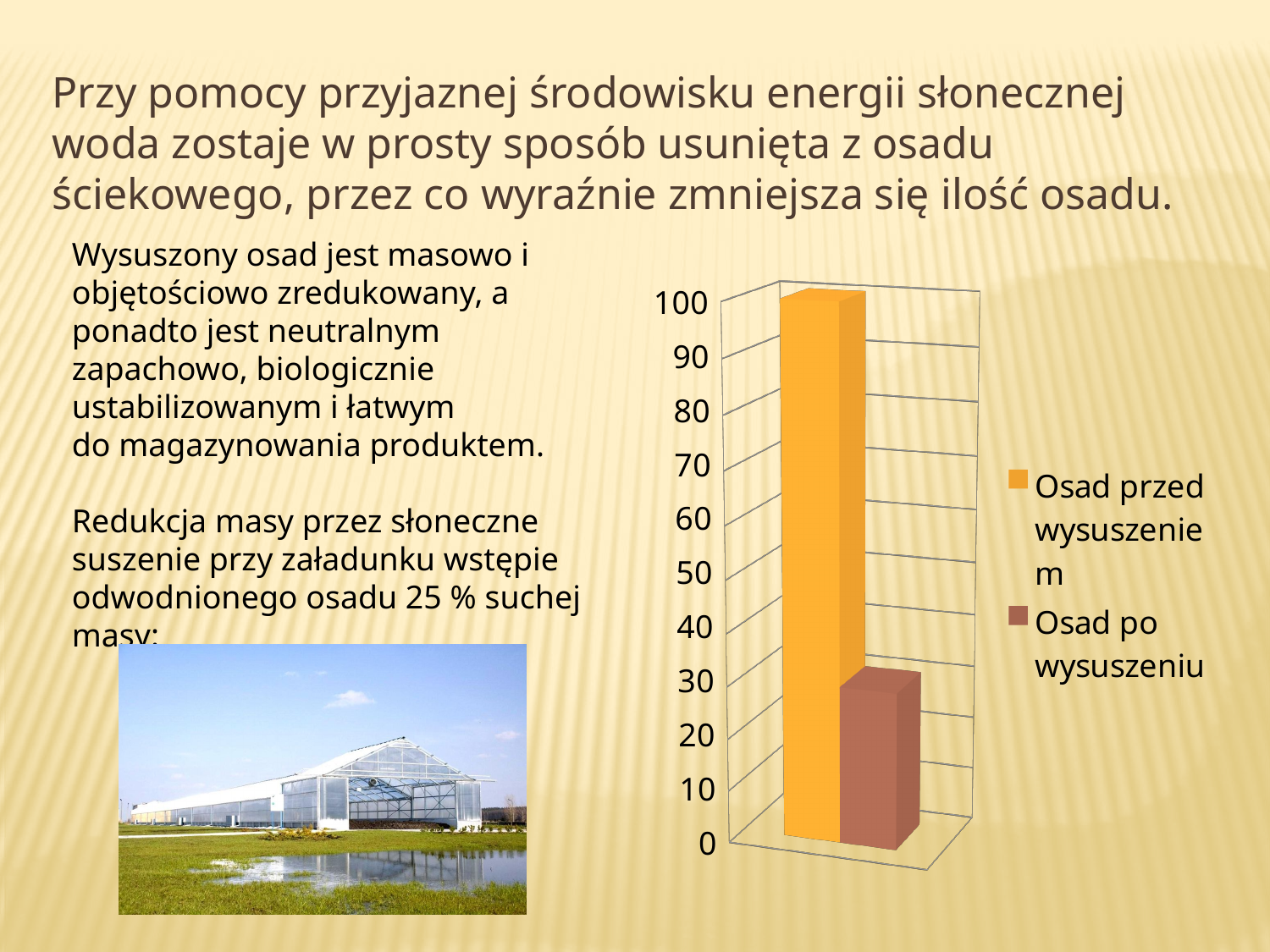
Which series has the highest value in the chart? Osad przed wysuszeniem How many series does the chart legend list? 2 Which series has the taller bar, Osad przed wysuszeniem or Osad po wysuszeniu? Osad przed wysuszeniem What colour is the bar for Osad po wysuszeniu? brown Which series has the lowest value in the chart? Osad po wysuszeniu Is the value for Osad przed wysuszeniem greater or less than 50? greater Is the value for Osad po wysuszeniu greater or less than 20? greater What is the highest value shown on the chart's vertical axis? 100 Is the value for Osad przed wysuszeniem greater or less than 80? greater What kind of chart is shown on the slide? bar chart